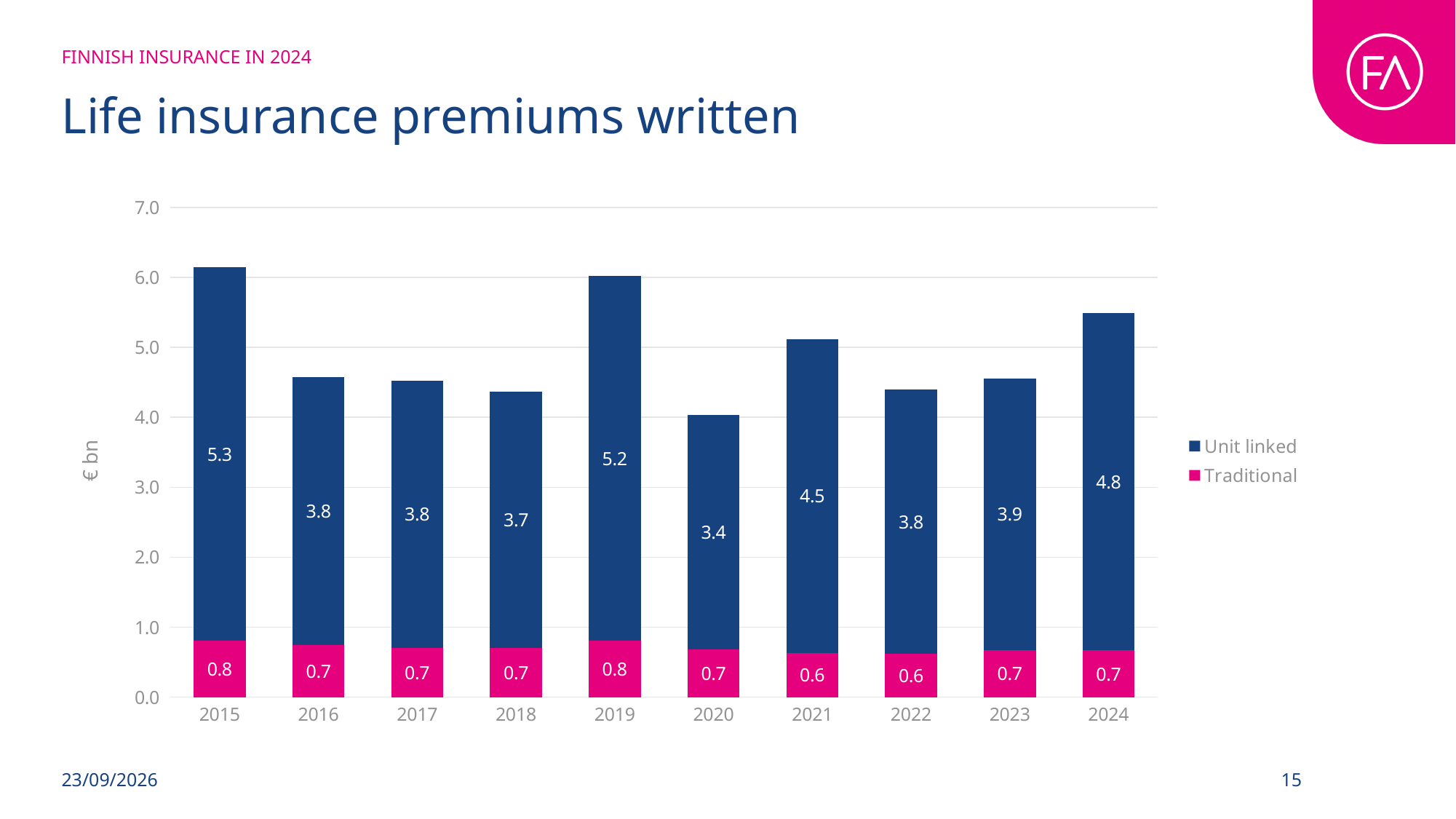
Which year has the highest Unit linked value? 2015 Is the total of the stacked bar for 2018 greater or less than 5.0? less Which year has the lowest Unit linked value? 2020 What is the difference between the Unit linked values for 2024 and 2023? 0.9 What is the Unit linked value for 2020? 3.4 How many years are shown on the x axis? 10 What is the total of the stacked bar for 2024? 5.5 How many series does the legend list? 2 What is the Unit linked value for 2024? 4.8 Which year has the larger Unit linked value, 2021 or 2022? 2021 What is the Traditional value for 2019? 0.8 What kind of chart is shown on the slide? Stacked bar chart